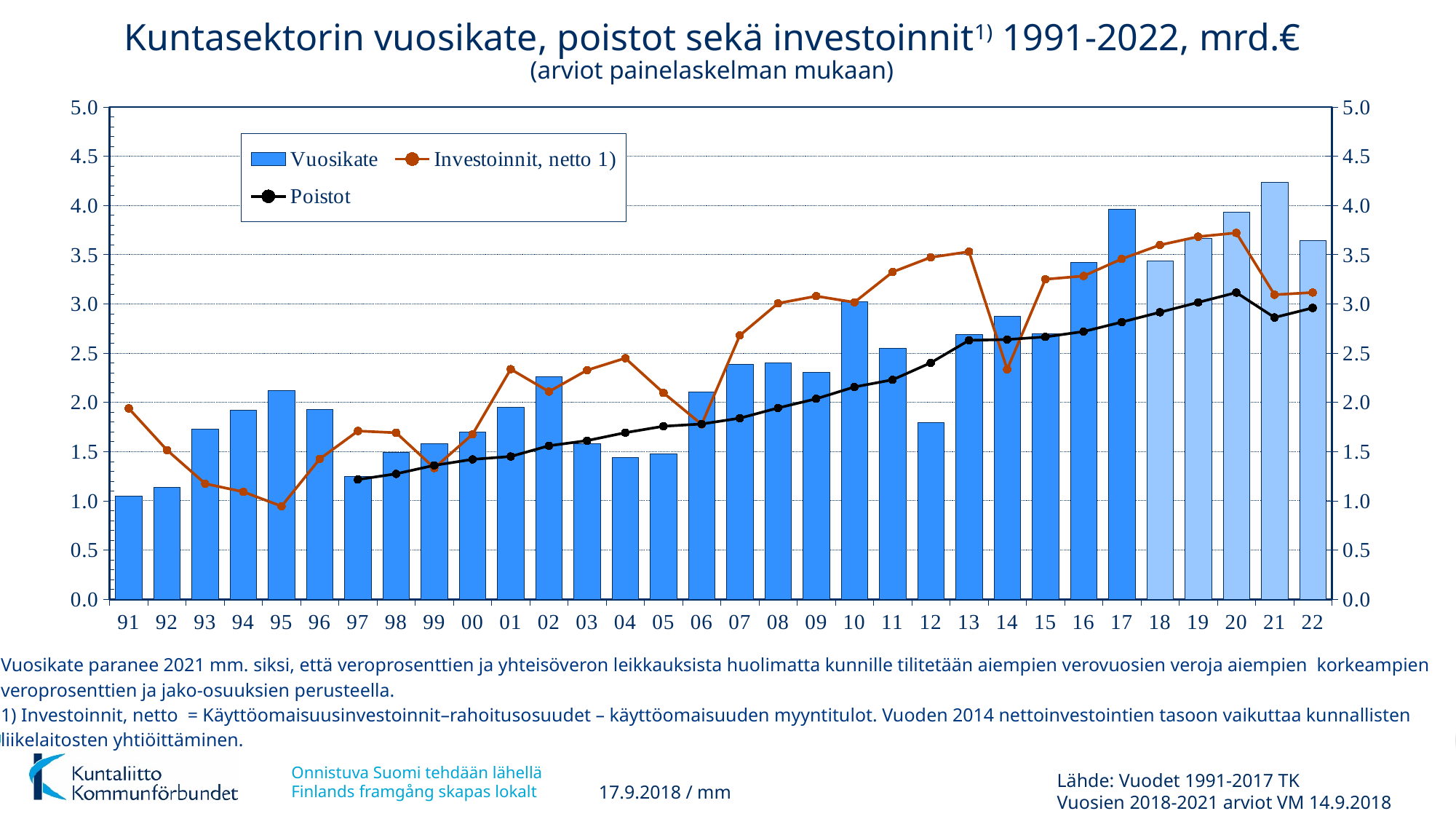
Is the Vuosikate value for 17 greater or less than 3.5? greater In which year is the Investoinnit, netto line at its lowest point? 95 How many years are shown on the x axis? 32 Which is larger in 14, the Investoinnit, netto value or the Poistot value? Poistot Does the Poistot line generally rise or fall from 97 to 20? rise What kind of chart is used to show the Vuosikate series? Bar chart Is the Vuosikate value for 12 greater or less than 2.0? less Is the Investoinnit, netto value for 14 greater or less than 2.5? less What are the three series named in the legend? Vuosikate, Investoinnit, netto 1), Poistot In which year is the Vuosikate bar the lowest? 91 In which year is the Vuosikate bar the highest? 21 How many series does the legend list? 3